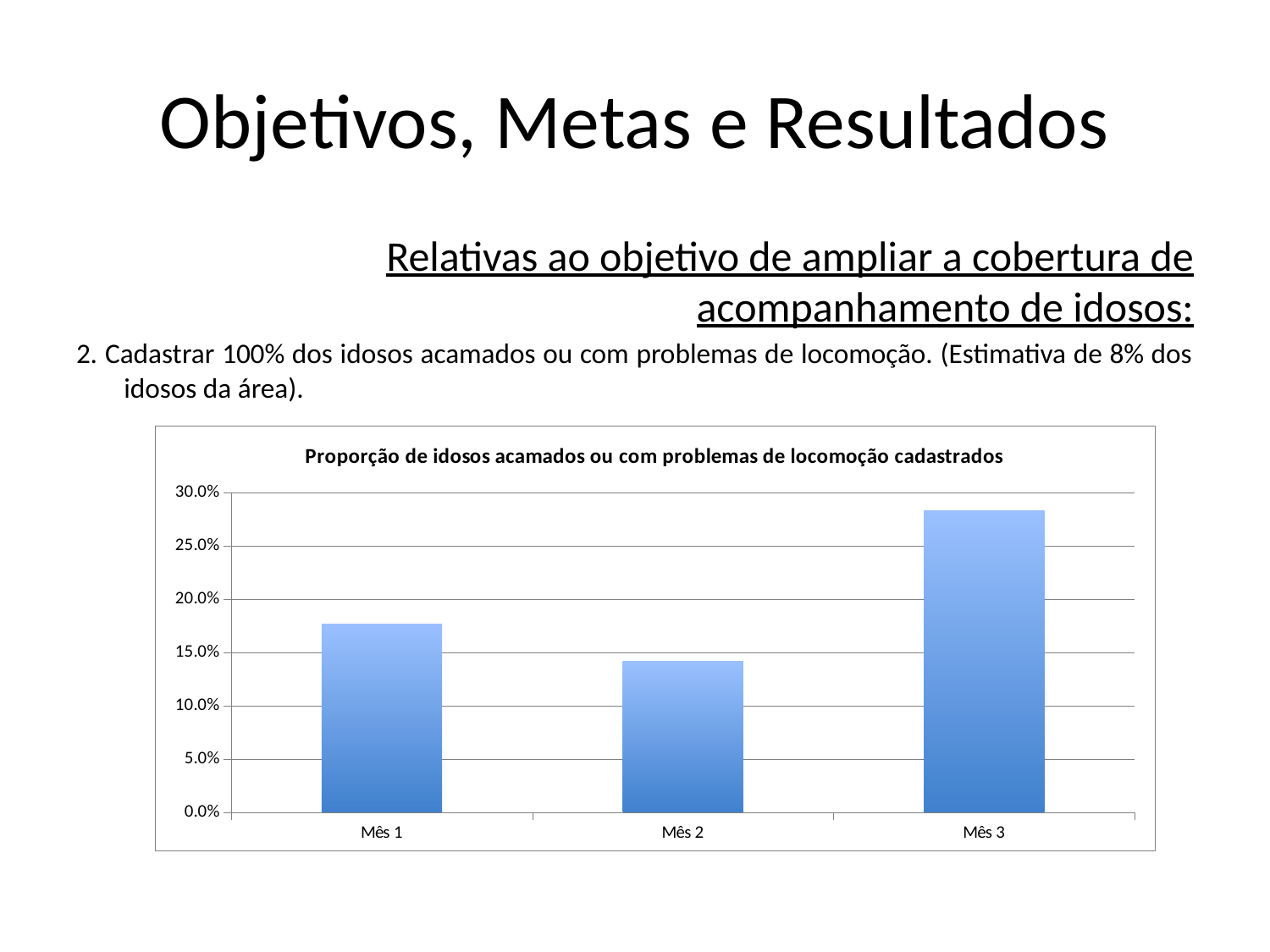
Which is larger, the value for Mês 3 or the value for Mês 1? Mês 3 Does the value rise or fall from Mês 2 to Mês 3? rise Is the value for Mês 3 greater or less than 30.0%? less Which month has the highest value in the chart? Mês 3 Is the value for Mês 3 greater or less than 25.0%? greater Which month has the lowest value in the chart? Mês 2 What is the title of the chart? Proporção de idosos acamados ou com problemas de locomoção cadastrados Which is larger, the value for Mês 1 or the value for Mês 2? Mês 1 What kind of chart is shown on the slide? bar chart Is the value for Mês 1 greater or less than 15.0%? greater How many categories (months) are plotted in the chart? 3